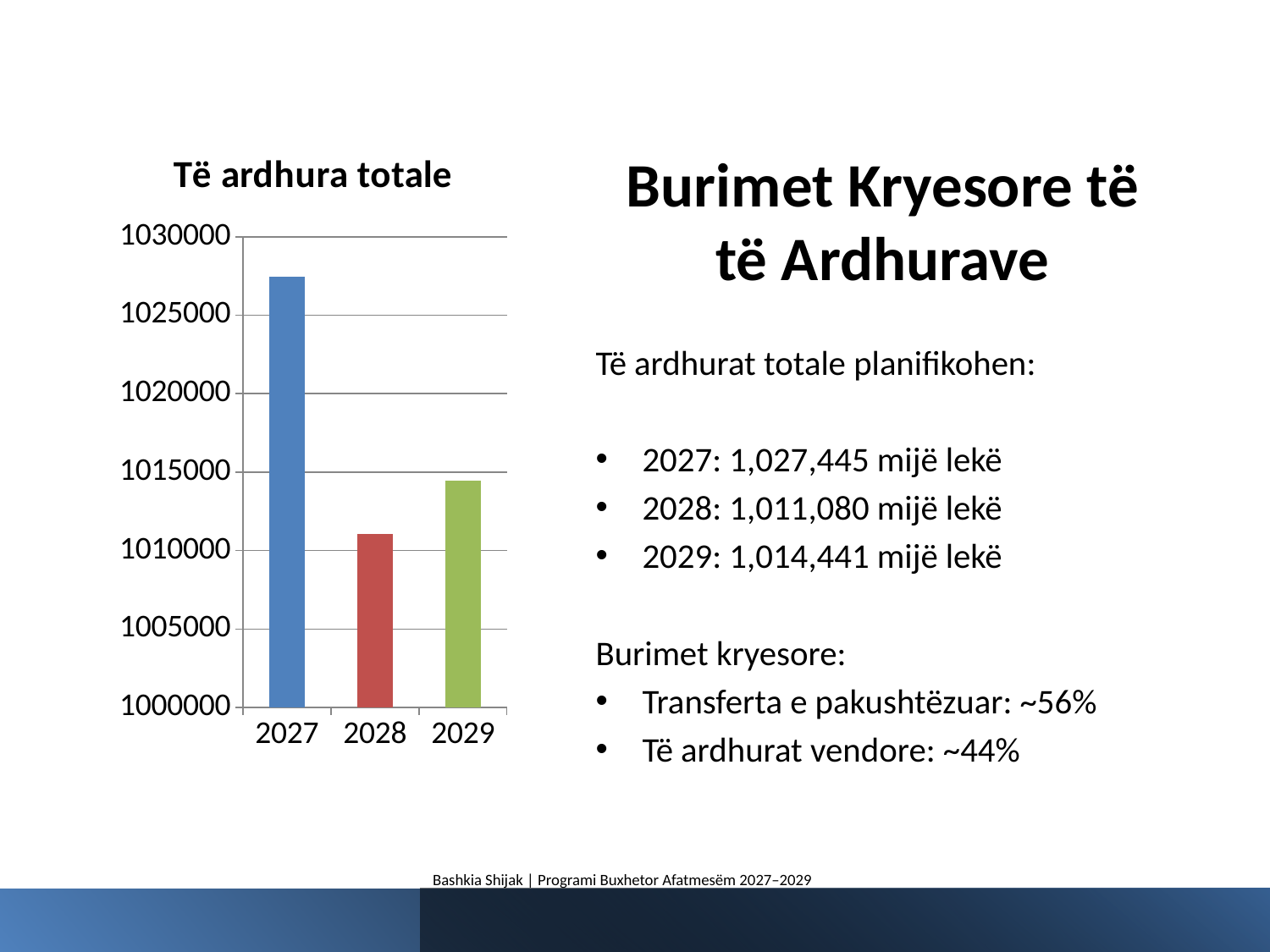
Is the value for 2029 greater or less than 1010000? greater How many years are plotted in the chart? 3 According to the slide, what is the planned total revenue for 2028 (in thousand lekë)? 1,011,080 Is the value for 2028 greater or less than 1015000? less What kind of chart is shown on the slide? bar chart Which year has the larger value in the chart, 2028 or 2029? 2029 Which year has the highest total revenue in the chart? 2027 What is the title of the chart? Të ardhura totale Is the value for 2027 greater or less than 1025000? greater Which year has the lowest total revenue in the chart? 2028 According to the slide, what is the planned total revenue for 2027 (in thousand lekë)? 1,027,445 What colour is the bar for 2027? blue